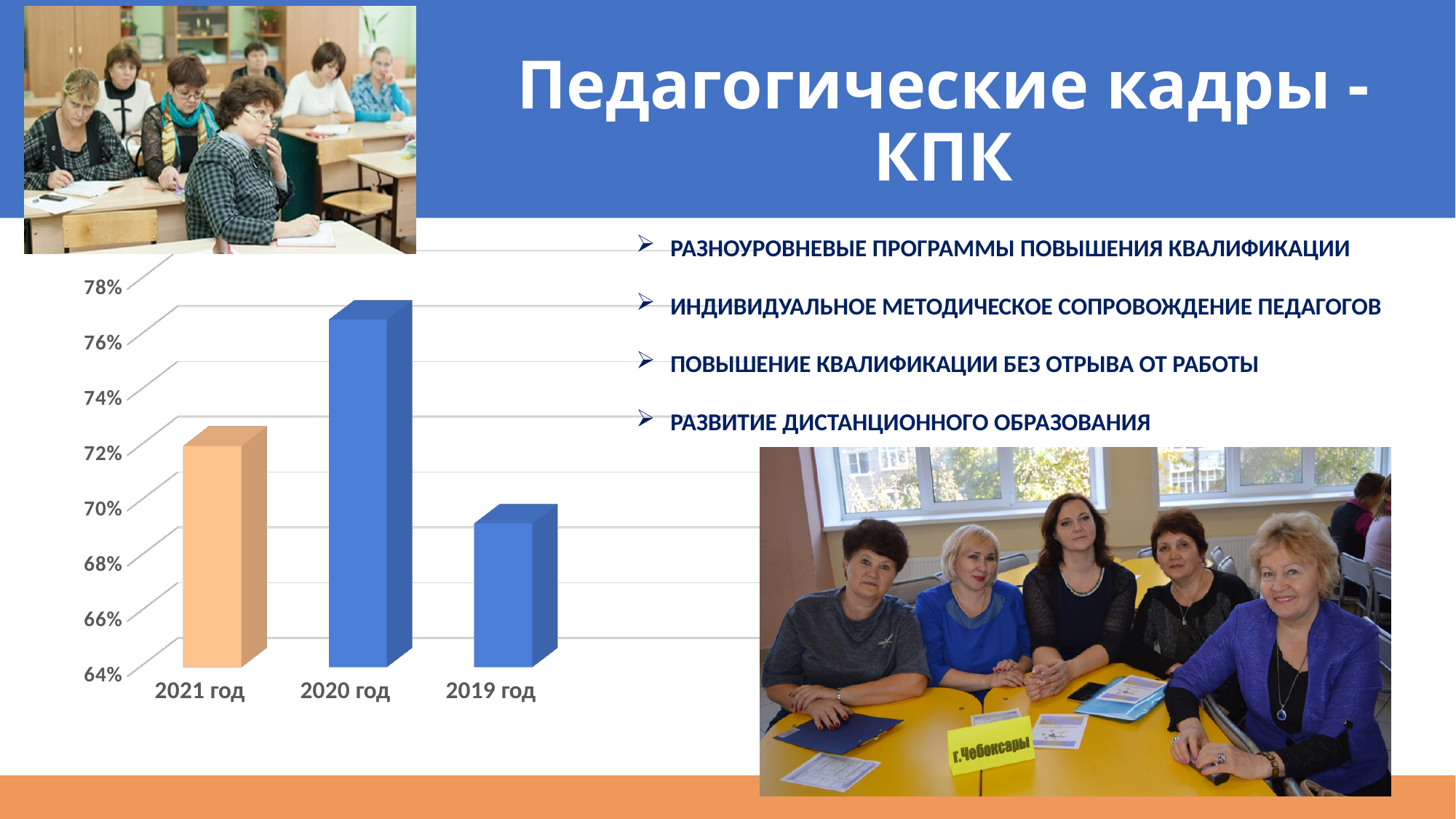
What kind of chart is shown on the slide? bar chart Is the value for 2019 год greater or less than 70%? less Is the value for 2021 год greater or less than 70%? greater Which year has the lowest value in the chart? 2019 год What colour is the bar for 2021 год? orange Is the value for 2021 год greater or less than 74%? less Which is larger, the value for 2020 год or the value for 2021 год? 2020 год Which is larger, the value for 2021 год or the value for 2019 год? 2021 год Which year has the highest value in the chart? 2020 год How many categories (years) are shown on the x axis of the chart? 3 Does the value rise or fall from 2020 год to 2019 год along the x axis? fall